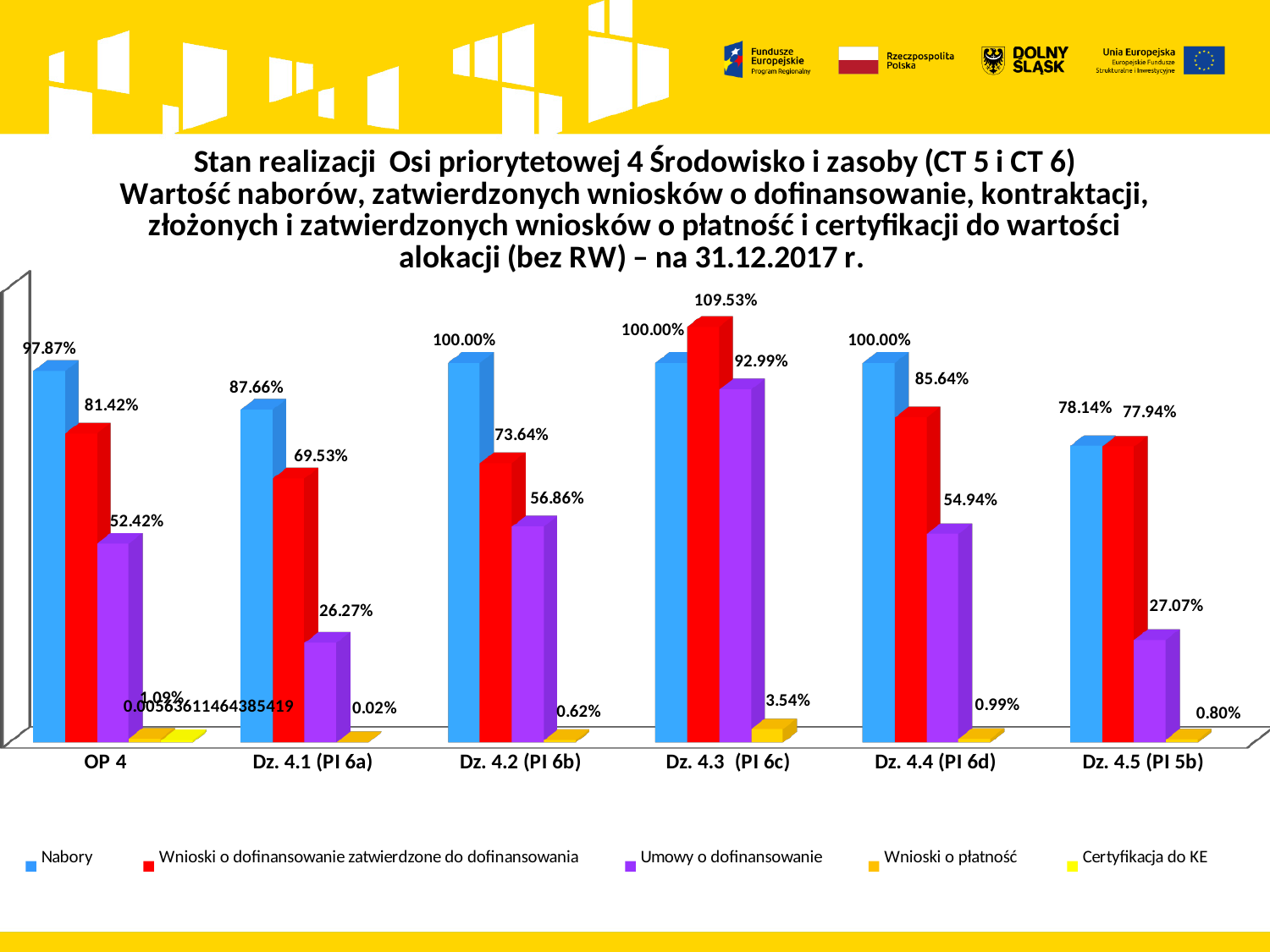
What is the value of Nabory for OP 4? 97.87% What is the value of Wnioski o dofinansowanie zatwierdzone do dofinansowania for Dz. 4.5 (PI 5b)? 77.94% What is the value of Wnioski o płatność for Dz. 4.3 (PI 6c)? 3.54% What is the value of Umowy o dofinansowanie for Dz. 4.3 (PI 6c)? 92.99% Which is larger: Nabory for Dz. 4.1 (PI 6a) or Nabory for Dz. 4.5 (PI 5b)? Dz. 4.1 (PI 6a) What kind of chart is shown on the slide? Bar chart How many categories are shown on the x axis? 6 How many series does the legend list? 5 Which category has the lowest value for Umowy o dofinansowanie? Dz. 4.1 (PI 6a) What is the difference between Nabory and Wnioski o dofinansowanie zatwierdzone do dofinansowania for Dz. 4.4 (PI 6d)? 14.36% By how much does Wnioski o dofinansowanie zatwierdzone do dofinansowania exceed Nabory for Dz. 4.3 (PI 6c)? 9.53% Which category has the highest value for Wnioski o dofinansowanie zatwierdzone do dofinansowania? Dz. 4.3 (PI 6c)